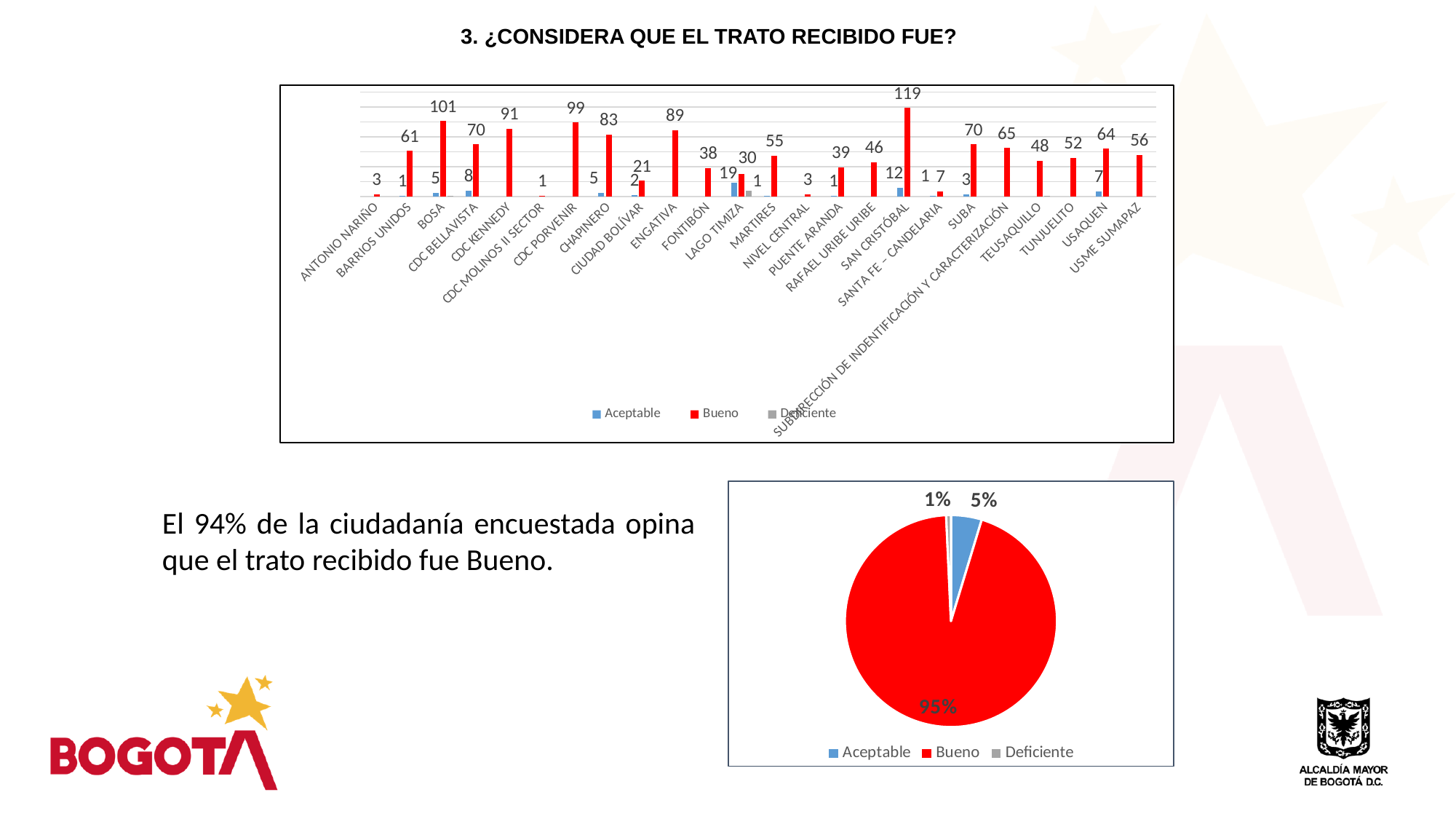
In the bar chart, which has a larger Bueno value, Usaquen or Usme Sumapaz? Usaquen What kind of chart is the top chart on the slide? Bar chart In the bar chart, what is the Bueno value for San Cristóbal? 119 In the pie chart, what share does Bueno have? 95% How many series does the bar chart's legend list? 3 In the bar chart, which category has the highest Bueno value? San Cristóbal In the bar chart, what is the Bueno value for Bosa? 101 How many categories are shown on the x axis of the bar chart? 24 In the pie chart, what share does Aceptable have? 5% In the bar chart, what is the difference between the Bueno values for CDC Kennedy and Engativa? 2 In the bar chart, what is the Aceptable value for Lago Timiza? 19 In the bar chart, what is the Bueno value for Chapinero? 83